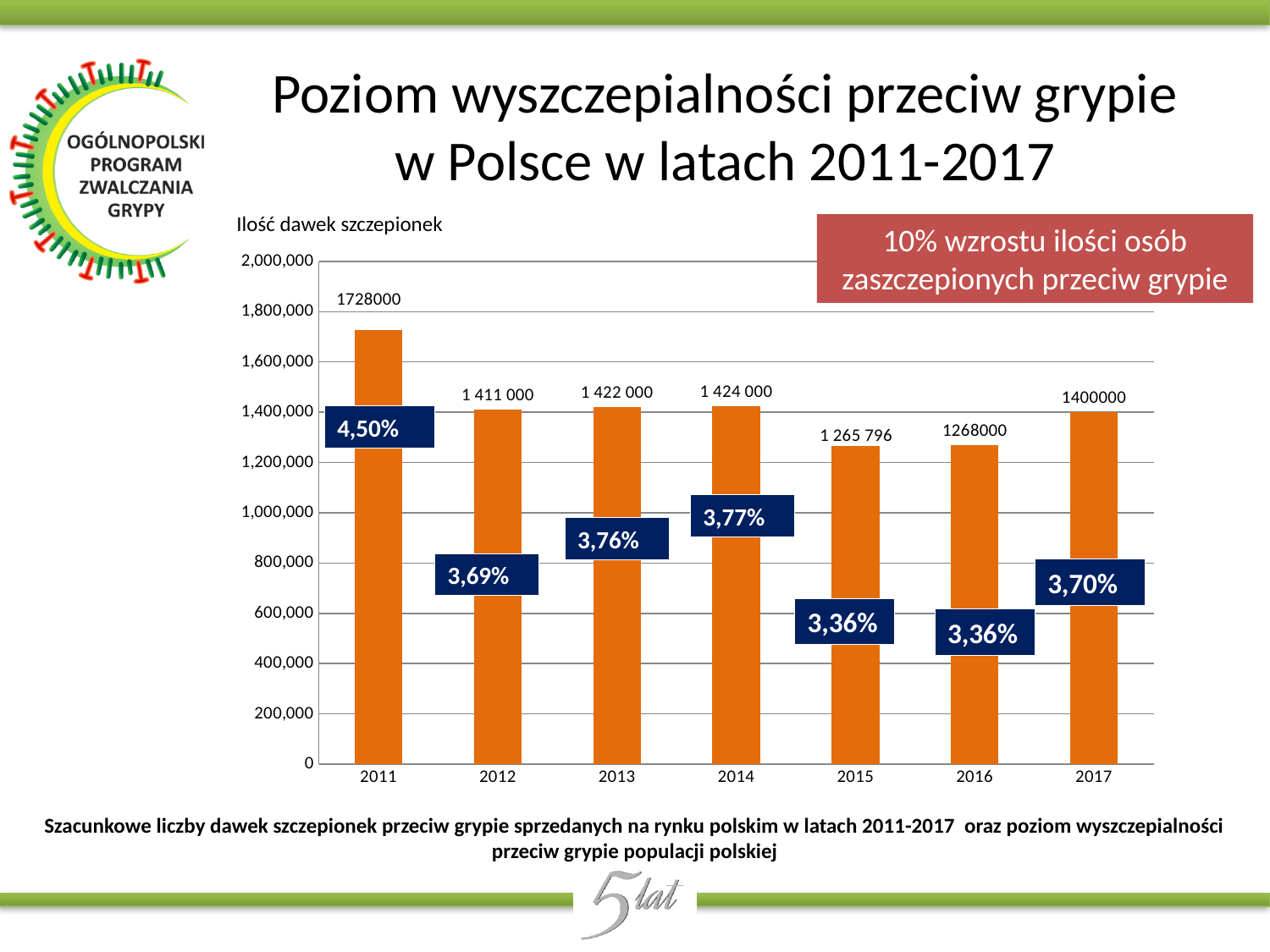
Which year has the highest vaccination rate percentage? 2011 What vaccination rate percentage is shown for 2014? 3,77% What vaccination rate percentage is shown for 2017? 3,70% Which year has the highest number of vaccine doses? 2011 What is the number of vaccine doses shown for 2011? 1728000 How many years are shown on the x axis of the chart? 7 What is the label shown above the y axis of the chart? Ilość dawek szczepionek What is the difference in vaccine doses between 2013 and 2012? 11 000 What is the number of vaccine doses shown for 2015? 1 265 796 What type of chart is shown on the slide? bar chart Which year has more vaccine doses, 2012 or 2017? 2012 Is the value for 2015 greater or less than 1,400,000? less